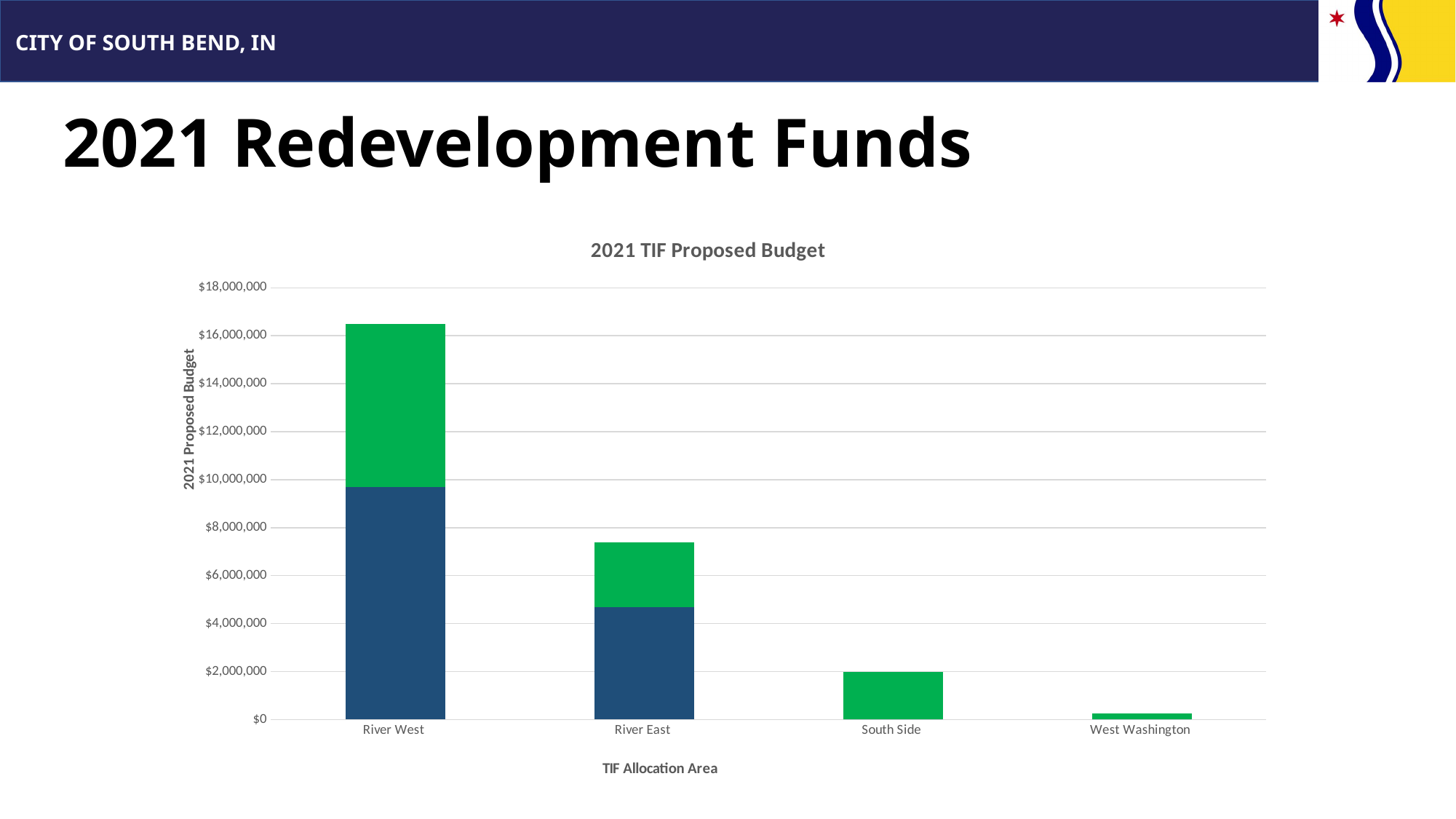
What kind of chart is shown on the slide? bar chart Is the bar for West Washington greater or less than $2,000,000? less Is the total bar for River West greater or less than $14,000,000? greater Which TIF allocation area has the lowest total proposed budget? West Washington Do the total bar heights rise or fall moving from River West to West Washington along the x axis? fall How many TIF allocation areas are shown on the x axis of the chart? 4 Which TIF allocation area has the highest total proposed budget? River West Is the total bar for River East greater or less than $8,000,000? less Which has a larger total proposed budget, River East or South Side? River East What is the title of the chart? 2021 TIF Proposed Budget